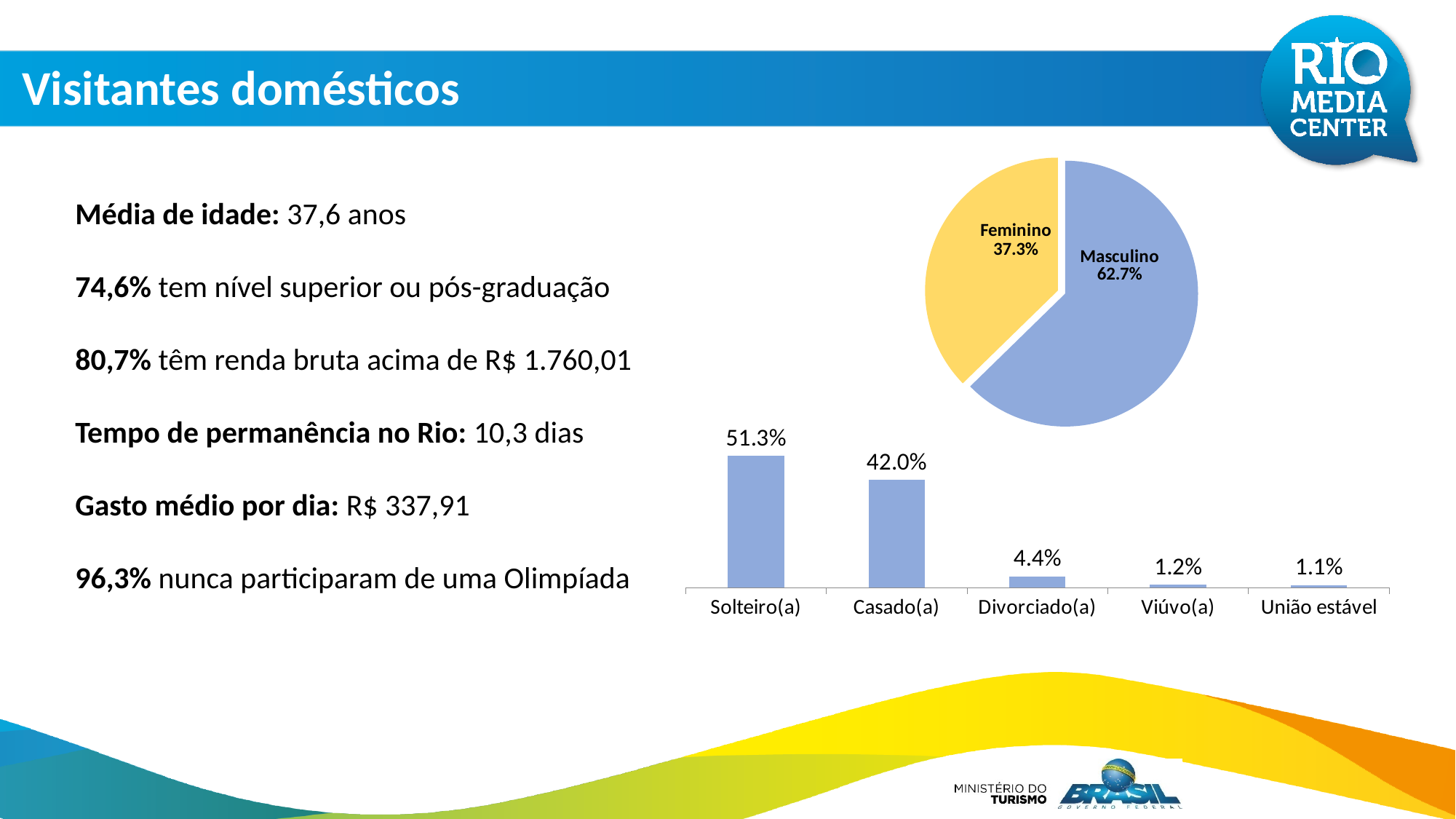
What kind of chart is the chart at the bottom right of the slide? Bar chart In the bar chart at the bottom right, what is the difference between the values for Solteiro(a) and Casado(a)? 9.3% In the bar chart at the bottom right, what is the value for Casado(a)? 42.0% In the bar chart at the bottom right, which category has the lowest value? União estável In the bar chart at the bottom right, what is the value for Divorciado(a)? 4.4% In the bar chart at the bottom right, what is the value for Solteiro(a)? 51.3% In the bar chart at the bottom right, which category has the highest value? Solteiro(a) In the pie chart at the top right, what share is labelled Masculino? 62.7% In the pie chart at the top right, what share is labelled Feminino? 37.3% How many slices does the pie chart at the top right have? 2 How many categories are shown in the bar chart at the bottom right? 5 In the pie chart at the top right, which slice is larger, Masculino or Feminino? Masculino